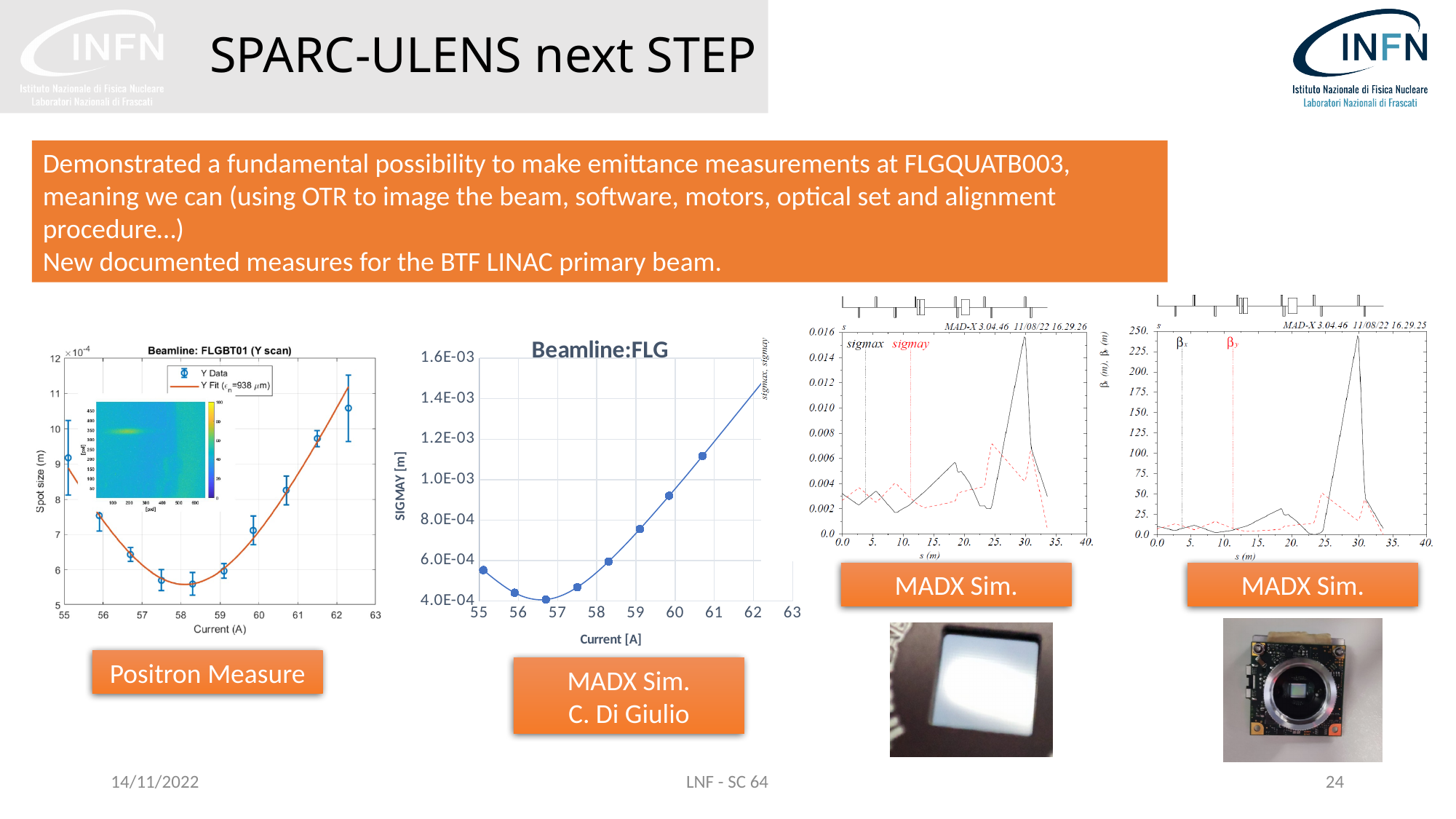
On the "Beamline:FLG" chart, does SIGMAY rise or fall as the current increases from 57 A to 62 A? rise What kind of chart is the "Beamline:FLG" chart? line chart How many data points are plotted on the "Beamline:FLG" chart? 9 On the "Beamline:FLG" chart, is SIGMAY larger at 55 A or at 62 A? 62 A On the right MADX Sim. chart (βx, βy vs s), is the peak value of βx greater or less than 200? greater How many Y Data points are plotted on the "Beamline: FLGBT01 (Y scan)" chart? 10 On the "Beamline:FLG" chart, is the lowest plotted SIGMAY value greater or less than 6.0E-04? less How many entries does the legend of the "Beamline: FLGBT01 (Y scan)" chart list? 2 What emittance value is given in the Y Fit legend entry of the "Beamline: FLGBT01 (Y scan)" chart? 938 μm What is the y-axis label of the "Beamline: FLGBT01 (Y scan)" chart? Spot size (m) On the left MADX Sim. chart (sigmax, sigmay vs s), which series reaches the higher peak near s = 30 m, sigmax or sigmay? sigmax On the "Beamline:FLG" chart, is the highest plotted SIGMAY value greater or less than 1.4E-03? greater